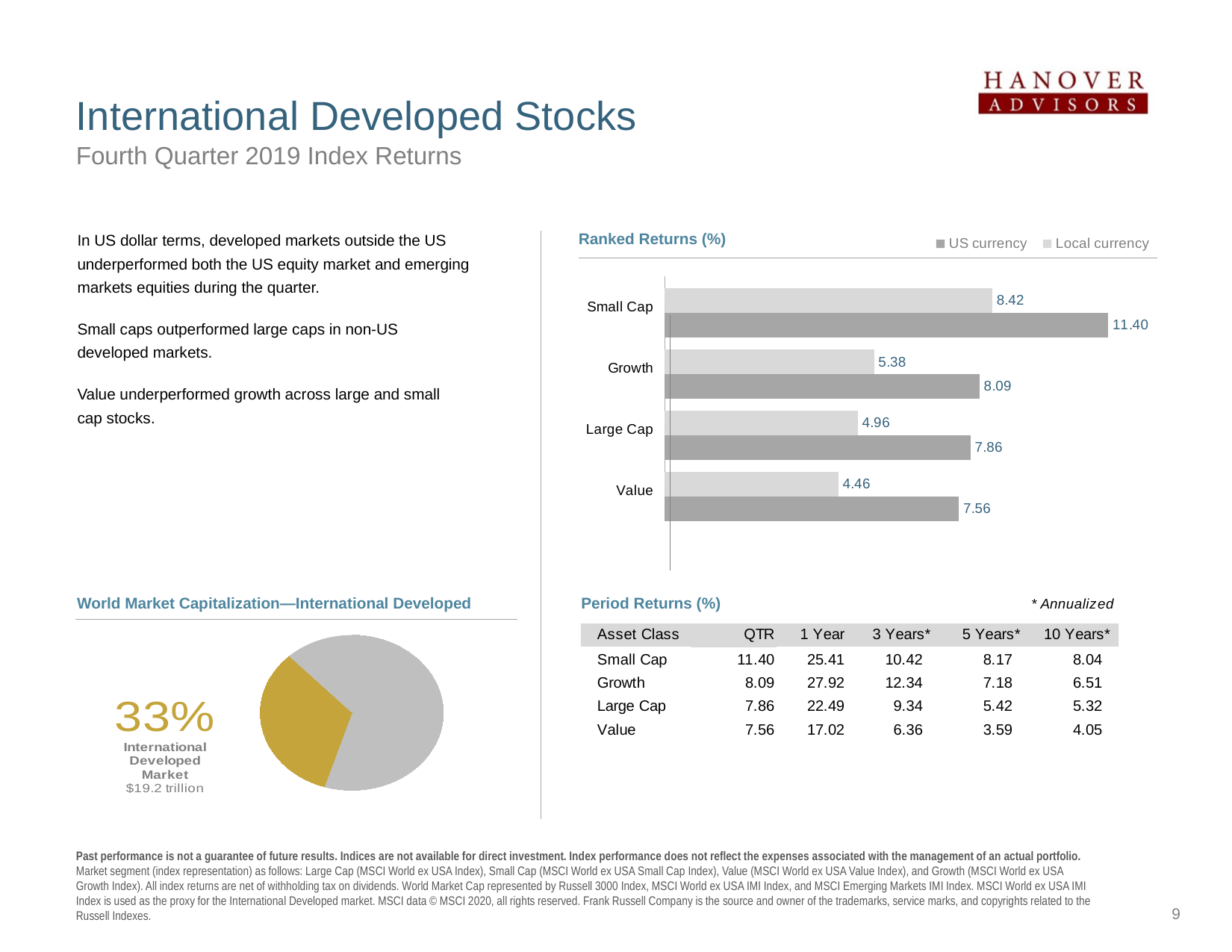
How many series does the legend of the Ranked Returns (%) chart list? 2 In the Ranked Returns (%) chart, which category has the lowest Local currency value? Value In the Ranked Returns (%) chart, what is the difference between the US currency and Local currency values for Large Cap? 2.90 In the Ranked Returns (%) chart, what is the Local currency value for Growth? 5.38 In the Ranked Returns (%) chart, which category has the highest US currency value? Small Cap In the World Market Capitalization—International Developed pie chart, what share does the International Developed Market slice represent? 33% How many categories are shown in the Ranked Returns (%) chart? 4 In the Ranked Returns (%) chart, what is the Local currency value for Value? 4.46 What kind of chart is the Ranked Returns (%) chart? Bar chart In the Ranked Returns (%) chart, which is larger: the US currency value for Growth or the US currency value for Large Cap? Growth In the Ranked Returns (%) chart, what is the US currency value for Small Cap? 11.40 What kind of chart is the World Market Capitalization—International Developed chart? Pie chart